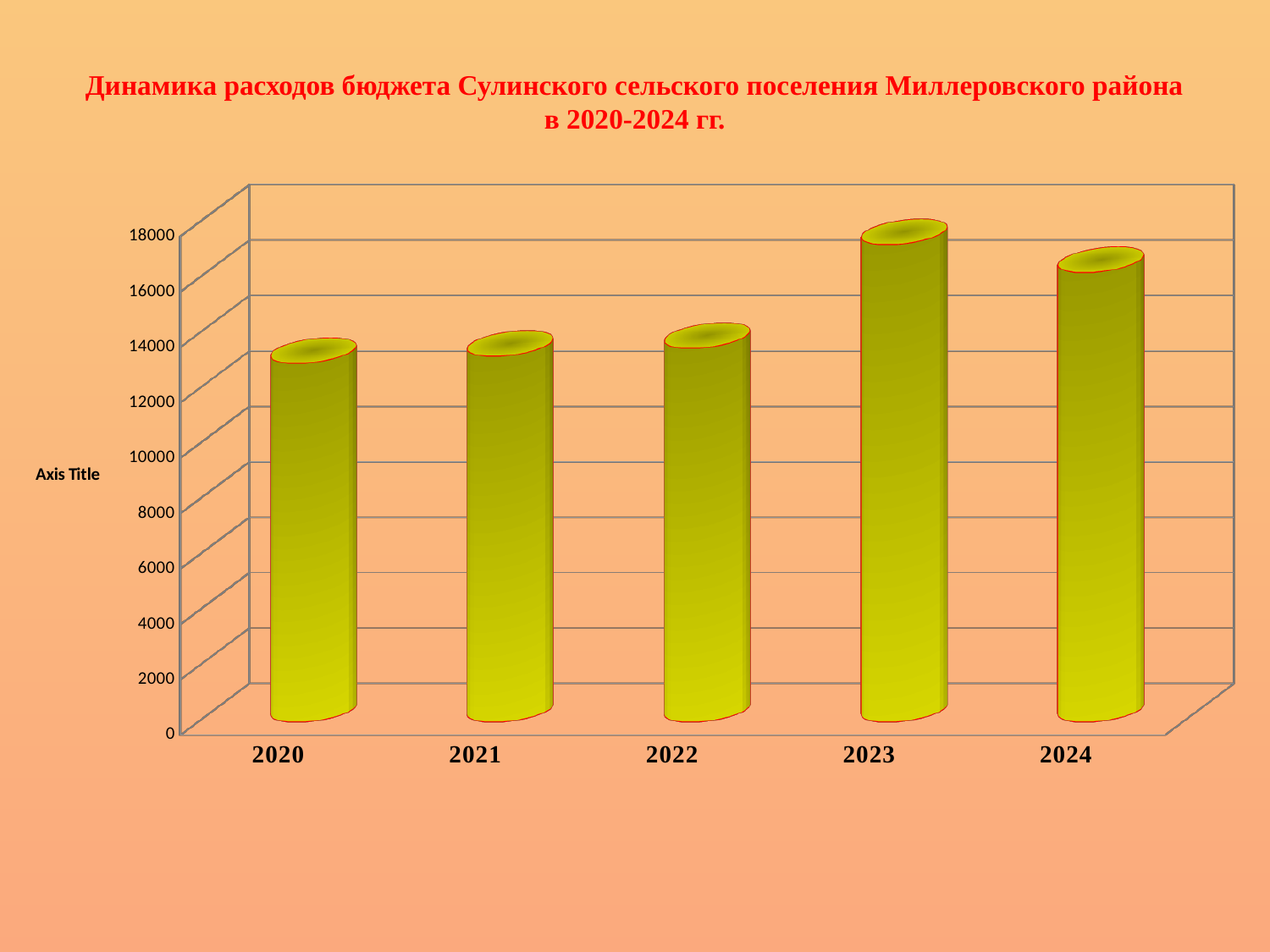
Does the value rise or fall from 2020 to 2023? rise How many years are shown on the x axis of the chart? 5 Does the value rise or fall from 2023 to 2024? fall Which is larger, the value for 2022 or the value for 2024? 2024 Is the value for 2022 greater or less than 16000? less Is the value for 2020 greater or less than 12000? greater Is the value for 2023 greater or less than 16000? greater What is the label shown on the vertical axis of the chart? Axis Title Which year has the highest value in the chart? 2023 Which is larger, the value for 2023 or the value for 2024? 2023 What kind of chart is shown on the slide? bar chart